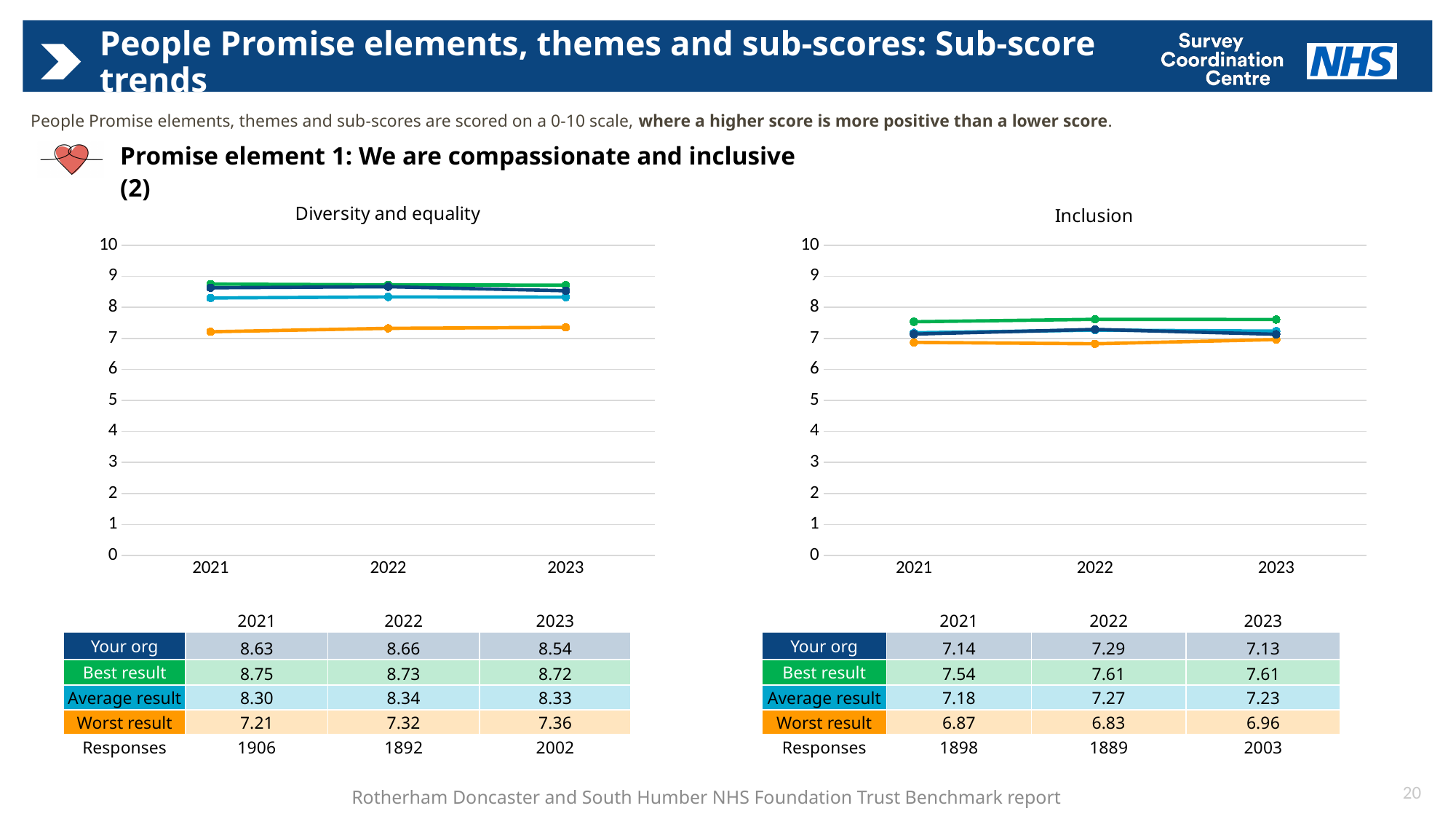
In the Diversity and equality chart, what is the difference between the Best result and the Worst result in 2021? 1.54 In the Inclusion chart, in which year was the Worst result score lowest? 2022 In the Inclusion chart, what is the Worst result score for 2021? 6.87 In the Diversity and equality chart, in which year was the Your org score highest? 2022 In the Diversity and equality chart, is the Worst result value for 2023 greater or less than 8? less In the Inclusion chart, what is the Best result score for 2022? 7.61 In the Diversity and equality chart, what is the Average result score for 2022? 8.34 What type of chart is used for Diversity and equality? Line chart In the Inclusion chart, what is the difference between the Your org score in 2022 and in 2023? 0.16 In the Diversity and equality chart, what is the Your org score for 2023? 8.54 How many years are plotted on the x axis of the Inclusion chart? 3 In the Inclusion chart, which is larger in 2021: the Your org score or the Average result score? Average result